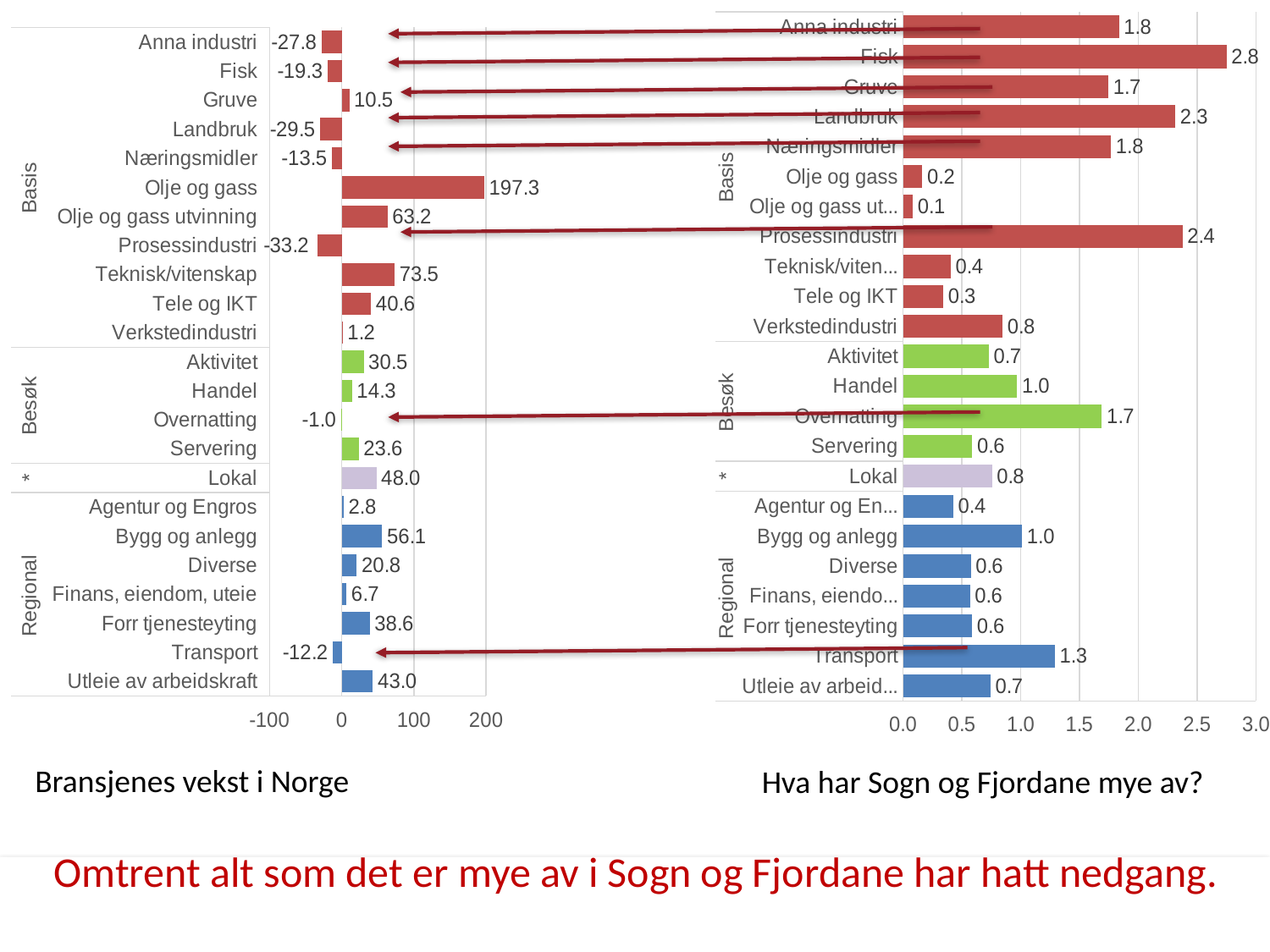
In the chart 'Hva har Sogn og Fjordane mye av?', what is the value for Transport? 1.3 In the chart 'Bransjenes vekst i Norge', what is the difference between the values for Olje og gass and Teknisk/vitenskap? 123.8 In the chart 'Bransjenes vekst i Norge', what is the value for Olje og gass? 197.3 In the chart 'Bransjenes vekst i Norge', what is the value for Prosessindustri? -33.2 In the chart 'Hva har Sogn og Fjordane mye av?', what is the value for Landbruk? 2.3 In the chart 'Bransjenes vekst i Norge', which is larger, the value for Bygg og anlegg or the value for Lokal? Bygg og anlegg What kind of chart is 'Hva har Sogn og Fjordane mye av?'? Bar chart In the chart 'Hva har Sogn og Fjordane mye av?', what is the difference between the values for Fisk and Landbruk? 0.5 In the chart 'Hva har Sogn og Fjordane mye av?', which category has the highest value? Fisk In the chart 'Bransjenes vekst i Norge', which category has the lowest value? Prosessindustri In the chart 'Bransjenes vekst i Norge', which category has the highest value? Olje og gass How many categories are shown in the chart 'Bransjenes vekst i Norge'? 23